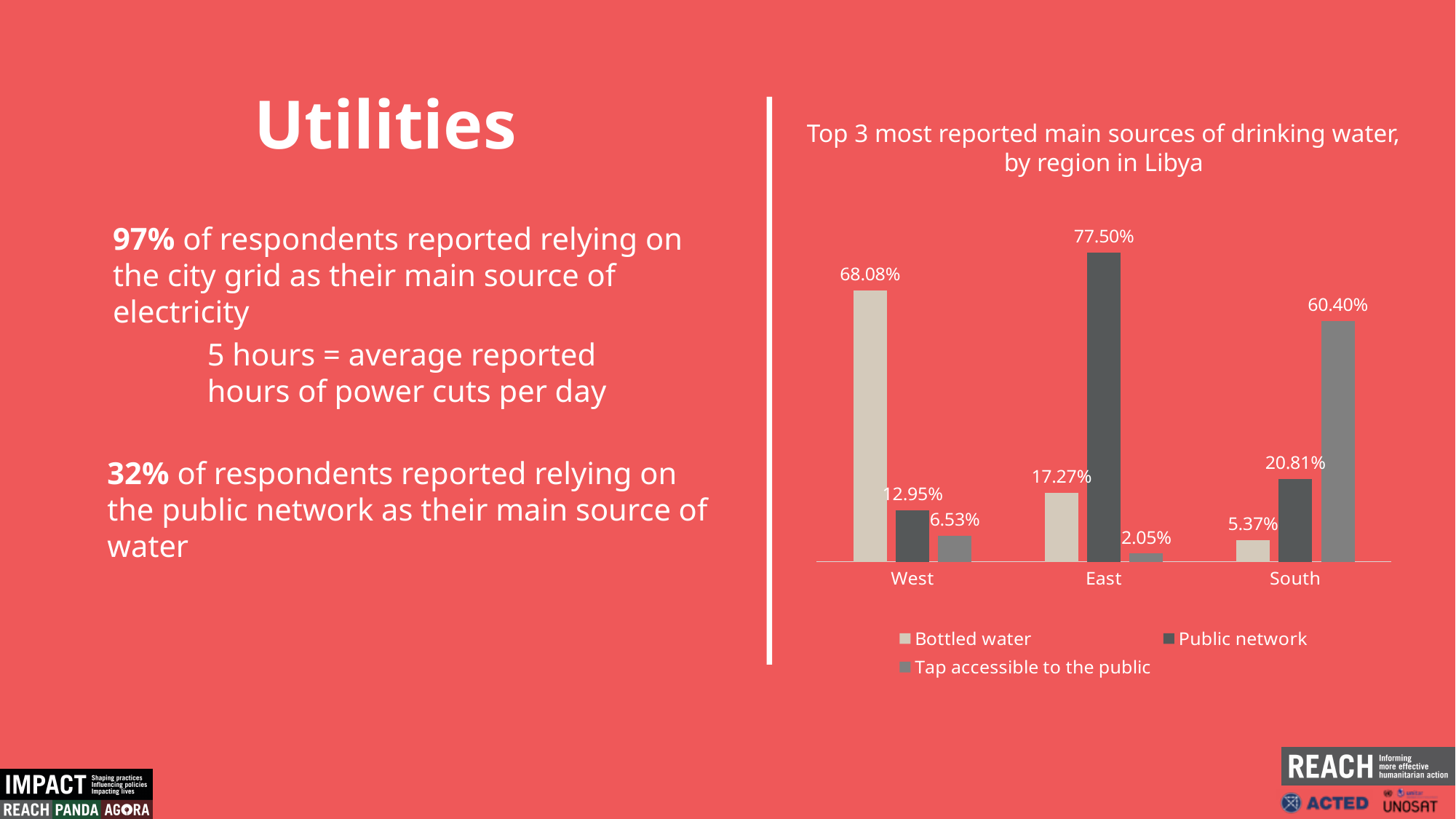
What is the title of the chart? Top 3 most reported main sources of drinking water, by region in Libya Which is larger in the South: Public network or Tap accessible to the public? Tap accessible to the public What is the difference between the Public network value in the East and the Public network value in the West? 64.55% How many regions are shown on the x axis of the chart? 3 What is the value for Bottled water in the South? 5.37% Which region has the highest value for Public network? East How many series does the chart's legend list? 3 What kind of chart is shown on the slide? Bar chart What percentage of respondents in the West reported bottled water as their main source of drinking water? 68.08% What is the value for Tap accessible to the public in the South? 60.40% Which region has the lowest value for Tap accessible to the public? East What is the value for Public network in the East? 77.50%